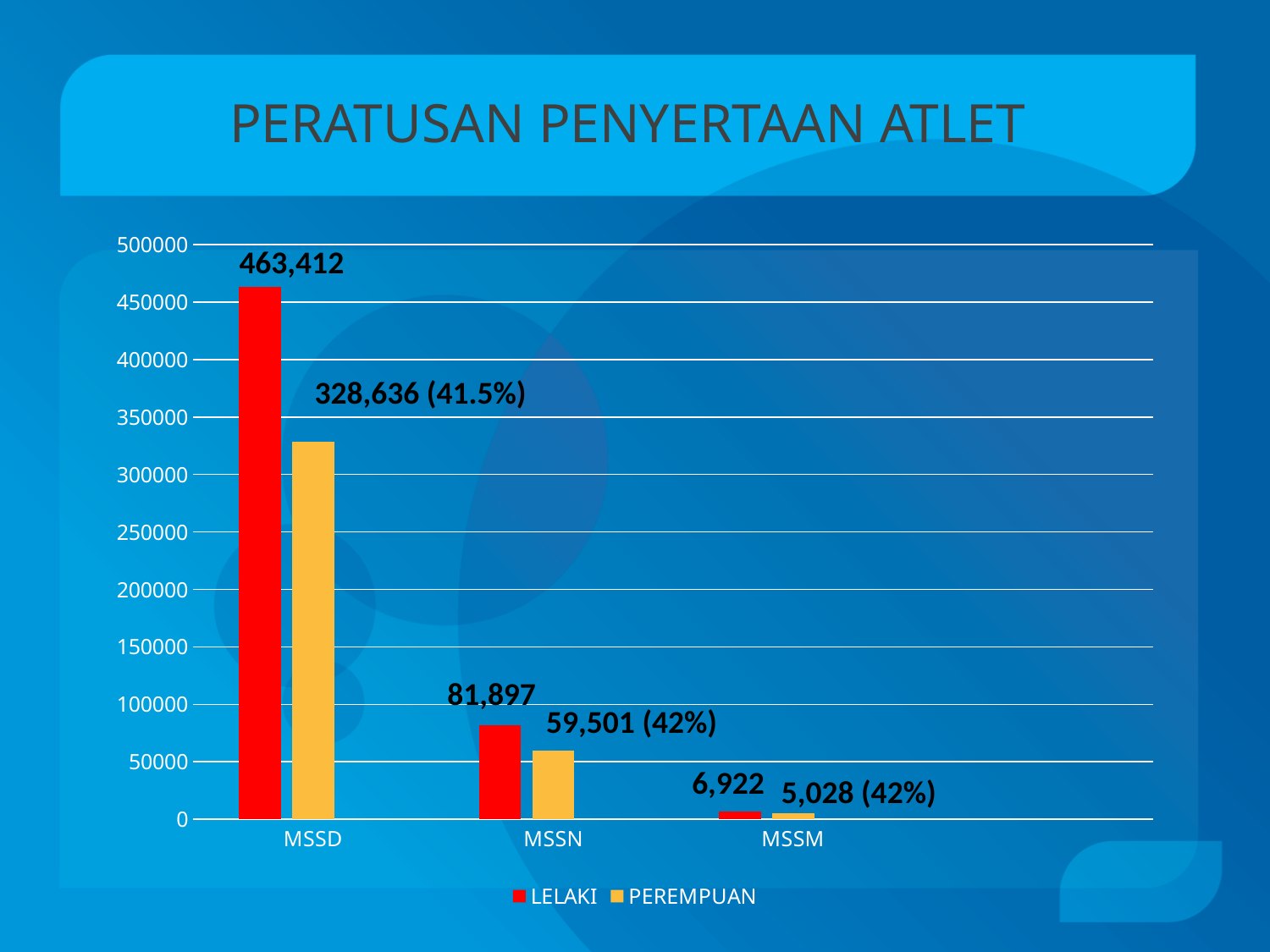
What is the PEREMPUAN value for MSSN? 59,501 (42%) Which category has the lowest PEREMPUAN value? MSSM Which category has the highest LELAKI value? MSSD What is the LELAKI value for MSSD? 463,412 Which is larger for MSSN, the LELAKI value or the PEREMPUAN value? LELAKI What kind of chart is shown on the slide? Bar chart What is the LELAKI value for MSSM? 6,922 How many categories are shown on the x axis? 3 What is the difference between the LELAKI and PEREMPUAN values for MSSD? 134,776 What is the title of the slide? PERATUSAN PENYERTAAN ATLET What is the PEREMPUAN value for MSSD? 328,636 (41.5%) How many series does the legend list? 2